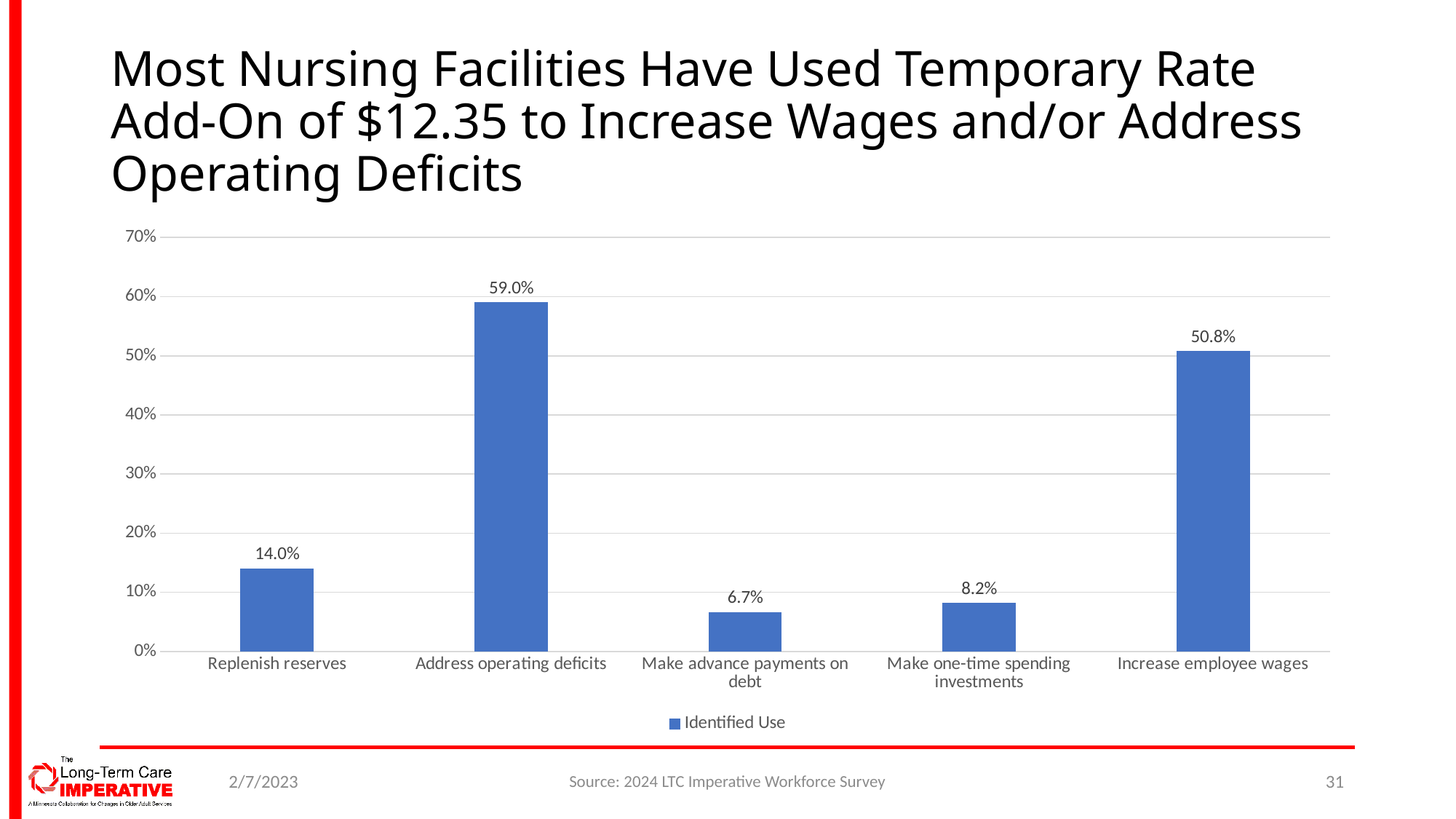
What is the value for Address operating deficits? 59.0% What is the value for Increase employee wages? 50.8% What is the difference between Address operating deficits and Increase employee wages? 8.2% What is the value for Make advance payments on debt? 6.7% Which category has the highest value? Address operating deficits Which is larger, Replenish reserves or Make one-time spending investments? Replenish reserves What kind of chart is shown on the slide? bar chart How many categories are shown on the x axis? 5 Is the value for Increase employee wages greater or less than 40%? greater What series name does the legend show? Identified Use What is the value for Replenish reserves? 14.0% Which category has the lowest value? Make advance payments on debt